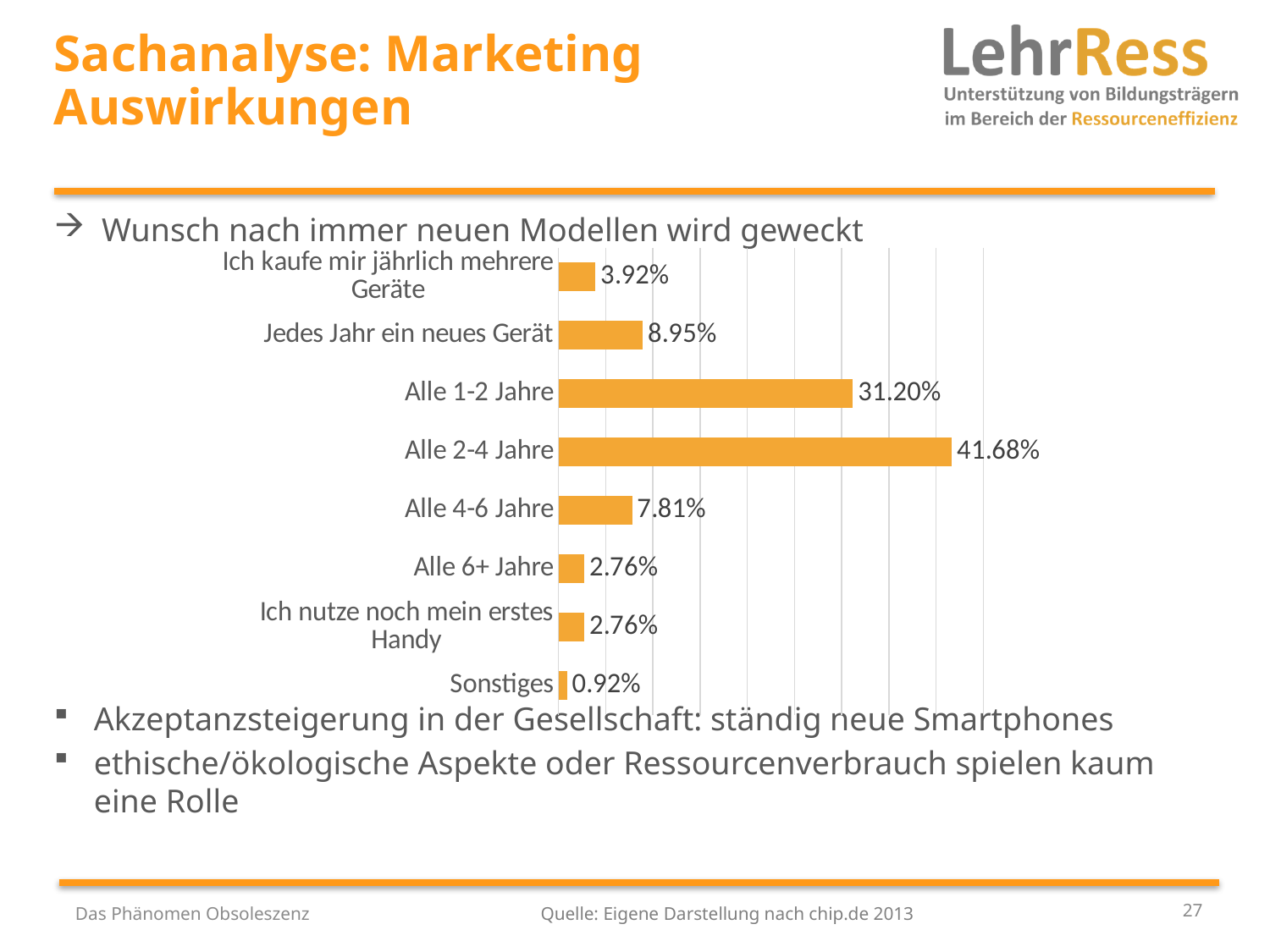
What is the value for "Ich nutze noch mein erstes Handy"? 2.76% What colour are the bars in the chart? Orange What is the difference between the values for "Alle 2-4 Jahre" and "Alle 1-2 Jahre"? 10.48% Which category has the highest value? Alle 2-4 Jahre What is the value for "Sonstiges"? 0.92% What is the difference between the values for "Jedes Jahr ein neues Gerät" and "Alle 4-6 Jahre"? 1.14% What is the value for "Alle 2-4 Jahre"? 41.68% What is the value for "Jedes Jahr ein neues Gerät"? 8.95% How many categories are shown in the chart? 8 What kind of chart is shown on the slide? Bar chart Which is larger, the value for "Ich kaufe mir jährlich mehrere Geräte" or the value for "Alle 4-6 Jahre"? Alle 4-6 Jahre Which category has the lowest value? Sonstiges